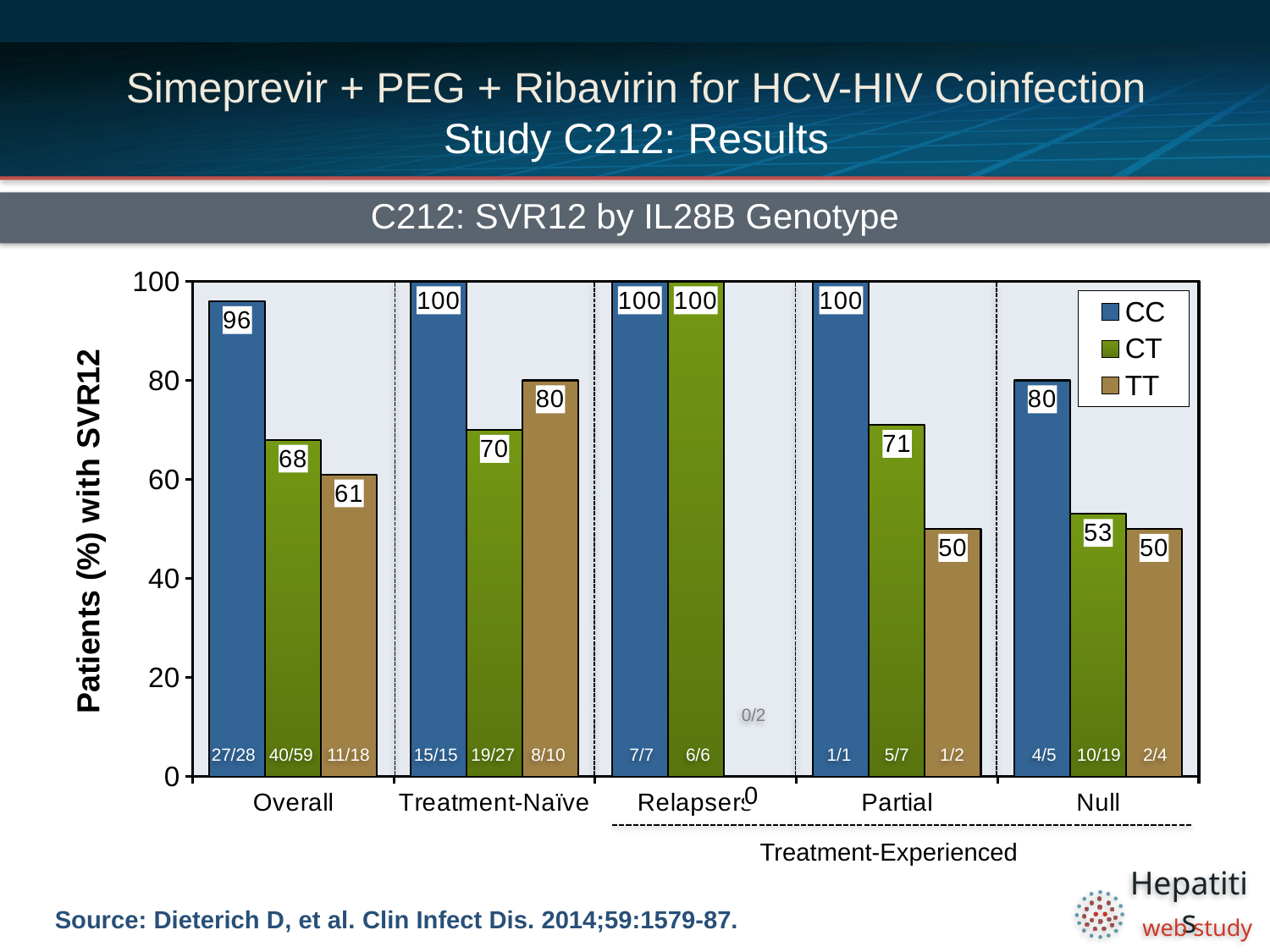
What type of chart is shown on the slide? Bar chart How many genotype series does the legend list? 3 Which genotype has the lowest SVR12 rate in the Overall group? TT Is the SVR12 rate for the CT genotype higher in the Treatment-Naïve group or in the Partial group? Partial What is the SVR12 rate for the CT genotype in the Null group? 53 What is the SVR12 rate for the CT genotype in the Partial group? 71 What is the title of the chart? C212: SVR12 by IL28B Genotype Which genotype has the highest SVR12 rate in the Null group? CC How many patient groups are shown along the x axis? 5 What is the SVR12 rate for the CC genotype in the Overall group? 96 What is the SVR12 rate for the TT genotype in the Treatment-Naïve group? 80 What is the difference between the CC and CT SVR12 rates in the Overall group? 28